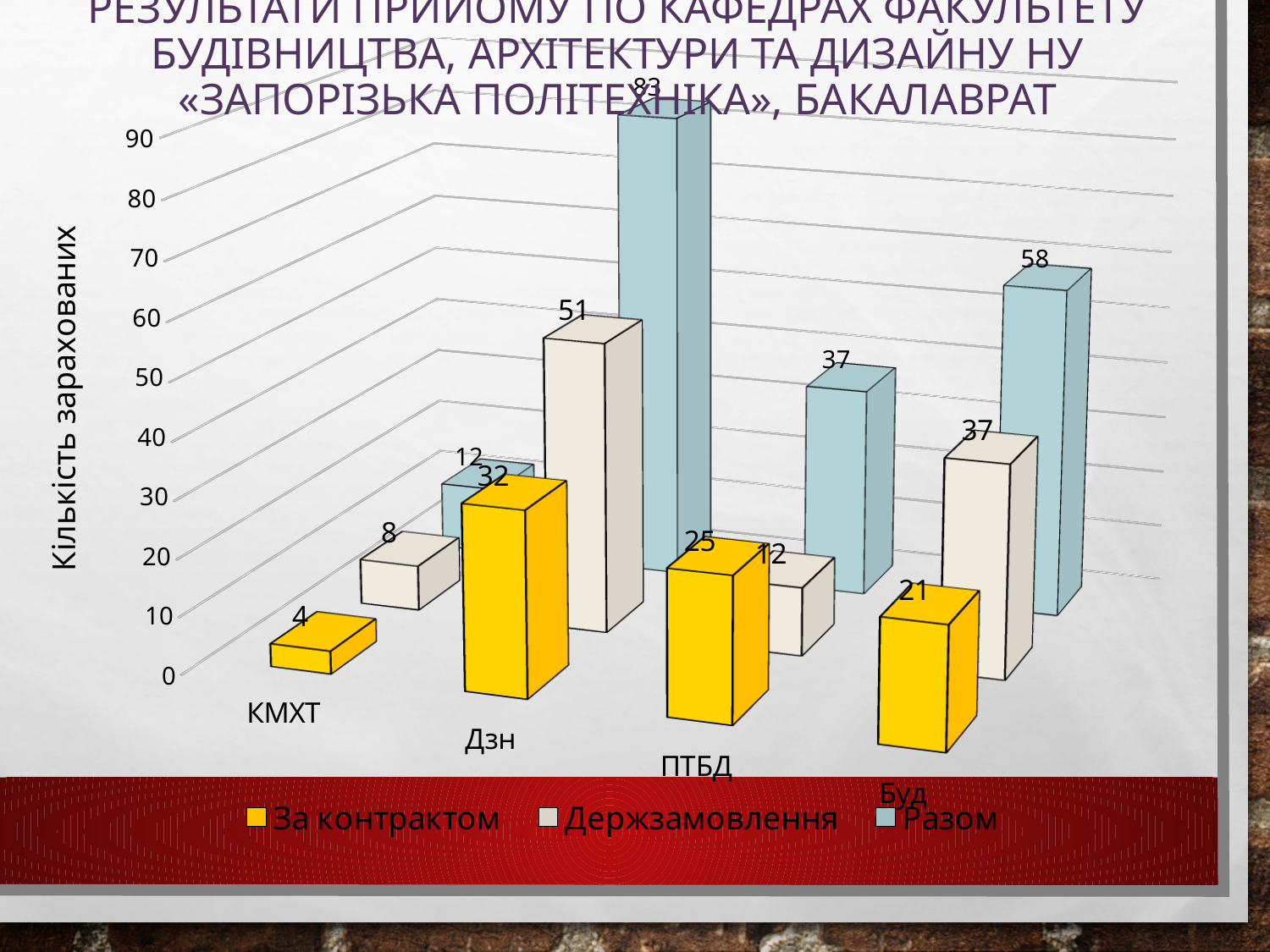
Which is larger: За контрактом for ПТБД or За контрактом for Буд? За контрактом for ПТБД What is the value of Держзамовлення for Буд? 37 How many categories are shown on the x axis? 4 What type of chart is shown on the slide? bar chart What is the value of За контрактом for Дзн? 32 How many series does the legend list? 3 What is the difference between the Разом values for Дзн and Буд? 25 What is the value of Разом for ПТБД? 37 What is the value of Держзамовлення for КМХТ? 8 Which category has the lowest За контрактом value? КМХТ Which category has the highest Разом value? Дзн What is the label of the vertical axis? Кількість зарахованих